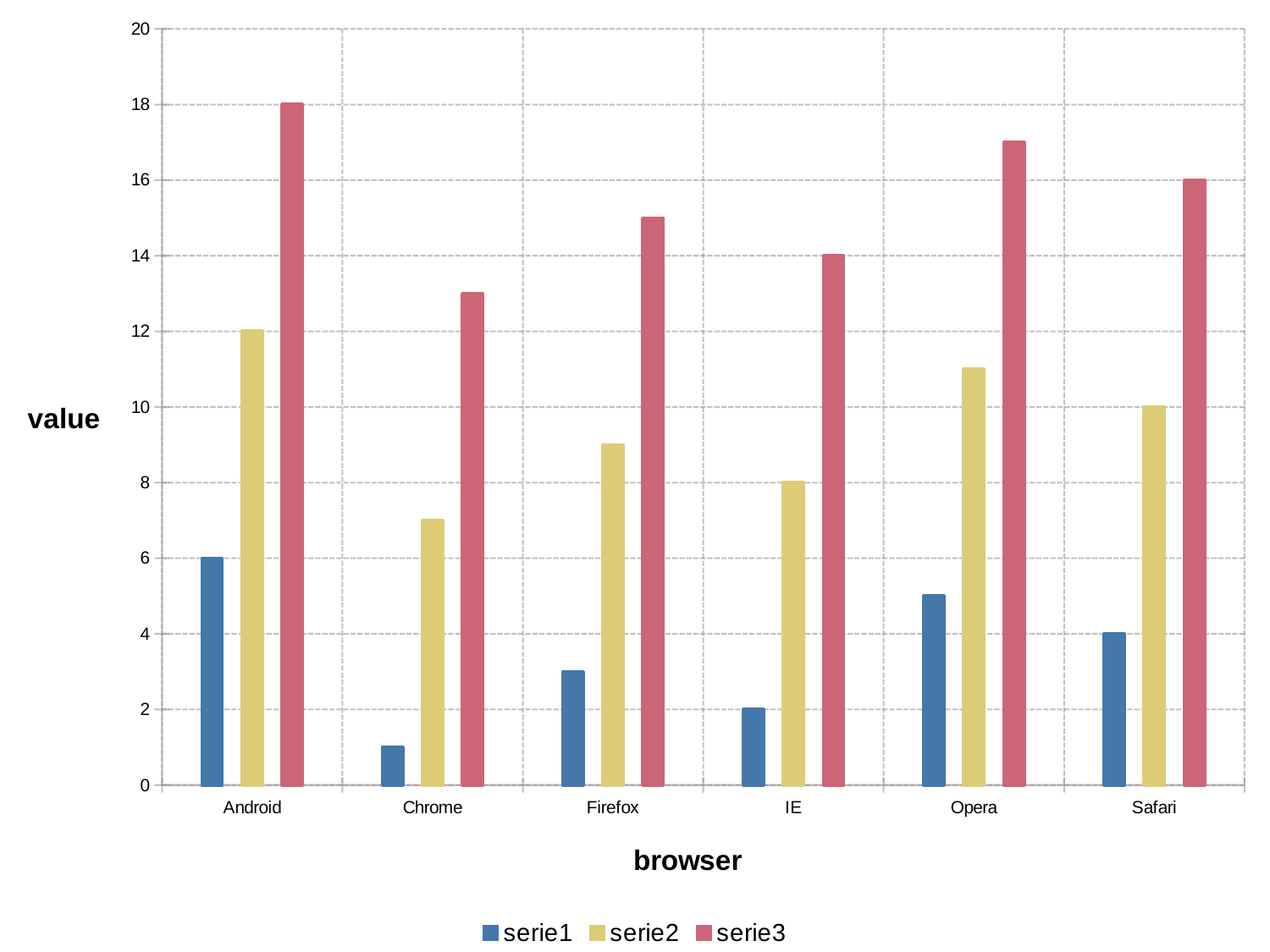
Is the serie2 value for Chrome greater or less than 8? less What is the value of serie3 for Android? 18 What is the value of serie2 for Safari? 10 What is the difference between the serie3 and serie1 values for Android? 12 What is the value of serie1 for Android? 6 Which browser has the highest serie3 value? Android How many browsers are shown on the x axis? 6 Which browser has the lowest serie1 value? Chrome Which is larger, the serie2 value for Opera or the serie2 value for Firefox? Opera What is the value of serie3 for IE? 14 Is the serie3 value for Opera greater or less than 16? greater How many series does the legend list? 3